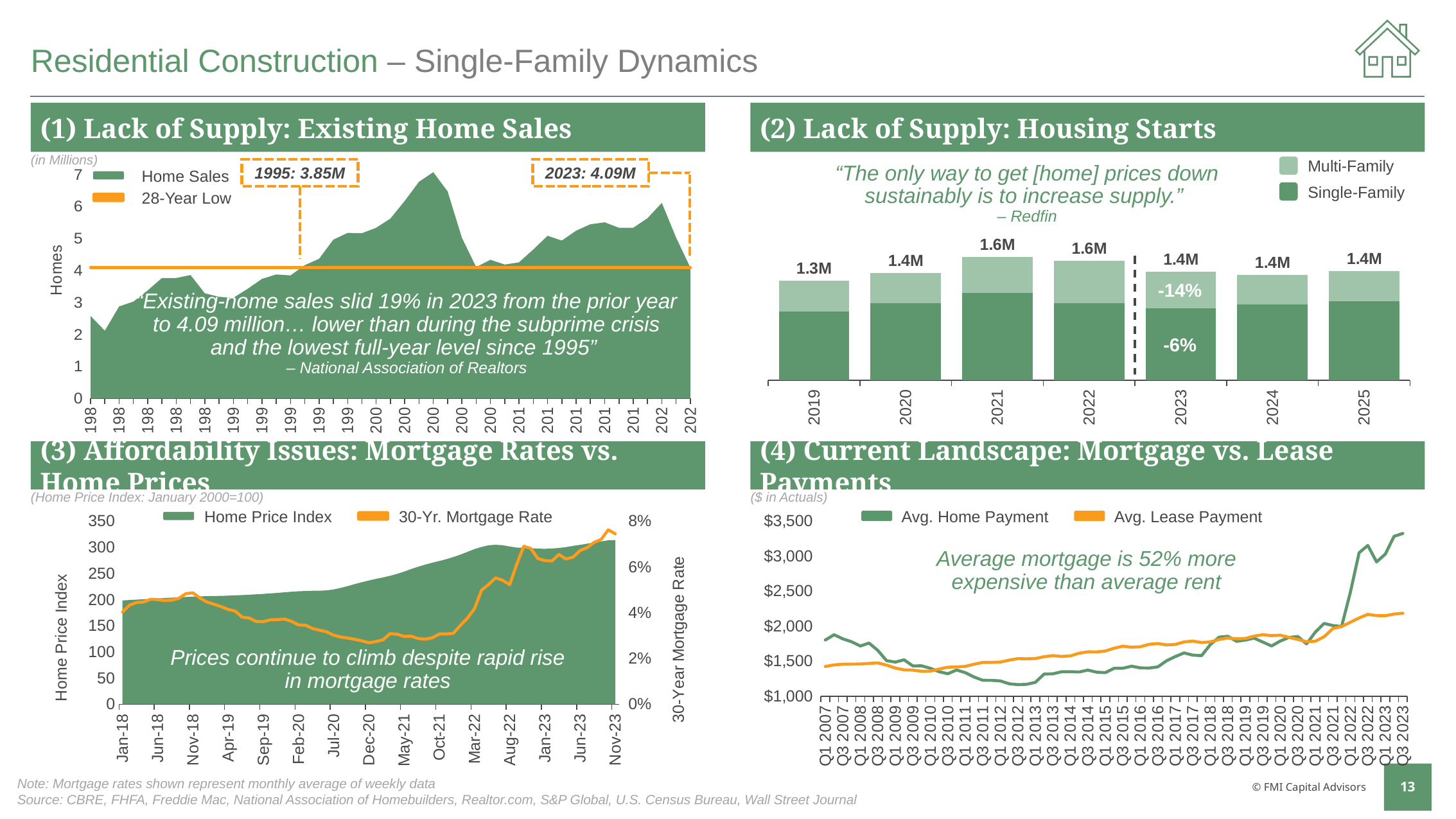
In the Mortgage vs. Lease Payments chart, which series is higher at Q3 2023: Avg. Home Payment or Avg. Lease Payment? Avg. Home Payment In the Housing Starts chart, how many series does the legend list? 2 In the Mortgage Rates vs. Home Prices chart, is the Home Price Index at Nov-23 greater or less than 300? greater In the Existing Home Sales chart, what value is labeled for 2023? 4.09M In the Housing Starts chart, what is the total housing starts value labeled for 2021? 1.6M What kind of chart is the Housing Starts chart? Bar chart In the Mortgage vs. Lease Payments chart, is the Avg. Home Payment at Q3 2023 greater or less than $3,000? greater In the Housing Starts chart, which year has the lowest total housing starts? 2019 In the Housing Starts chart, which year has the larger total: 2019 or 2021? 2021 In the Housing Starts chart, how many years are shown on the x axis? 7 In the Existing Home Sales chart, what is the difference between the 2023 value and the 1995 value? 0.24M In the Mortgage Rates vs. Home Prices chart, is the 30-Yr. Mortgage Rate at Dec-20 greater or less than 4%? less